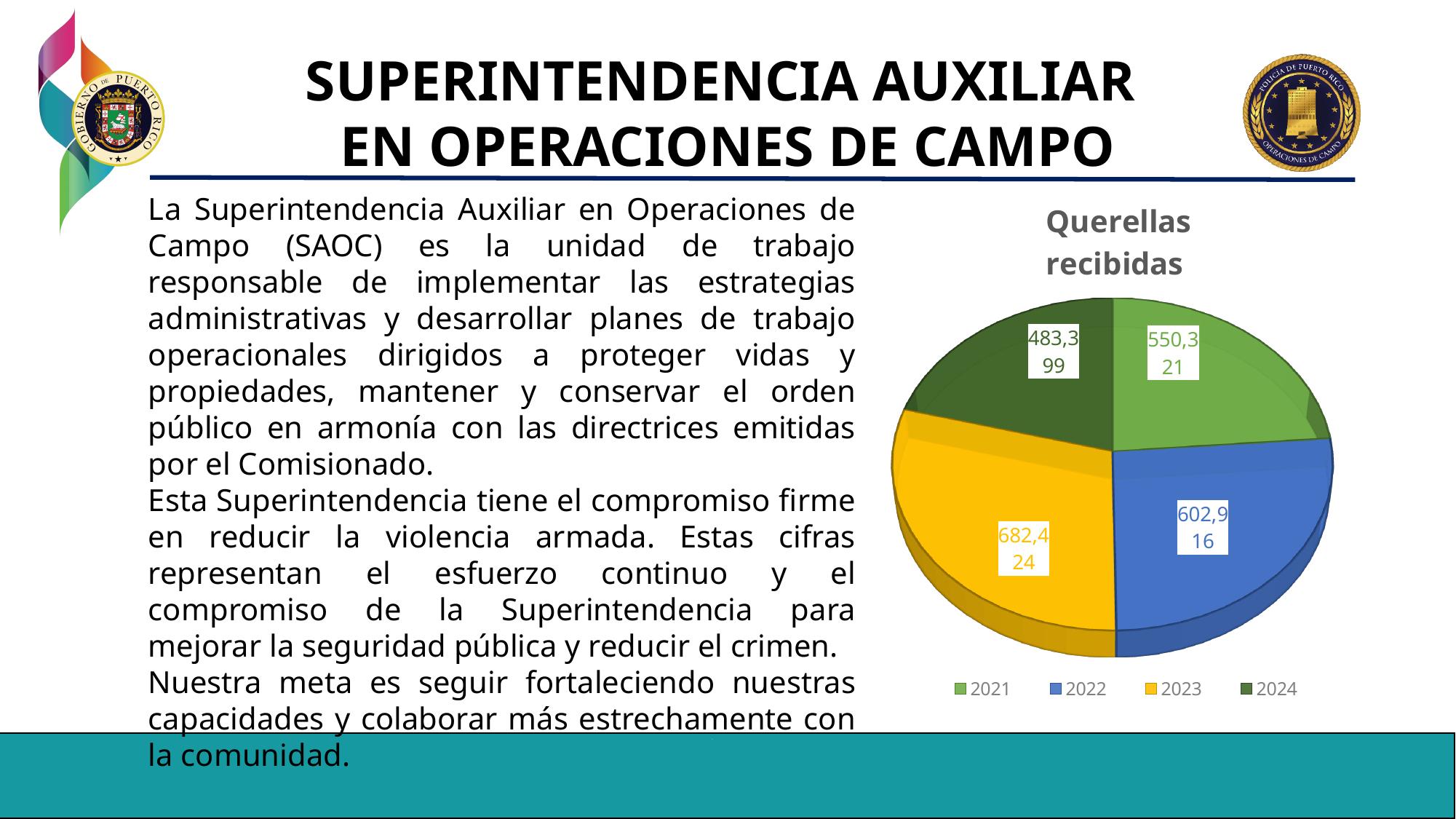
What is the value for 2022 in the pie chart? 602,916 Which is larger, the value for 2022 or the value for 2021? 2022 What is the value for 2024 in the pie chart? 483,399 Which year has the smallest slice in the pie chart? 2024 How many entries does the legend list? 4 What is the value for 2021 in the pie chart? 550,321 What is the value for 2023 in the pie chart? 682,424 What is the title of the chart? Querellas recibidas What is the difference between the values for 2023 and 2024? 199,025 Which year has the largest slice in the pie chart? 2023 How many slices does the pie chart have? 4 What kind of chart is shown on the slide? pie chart